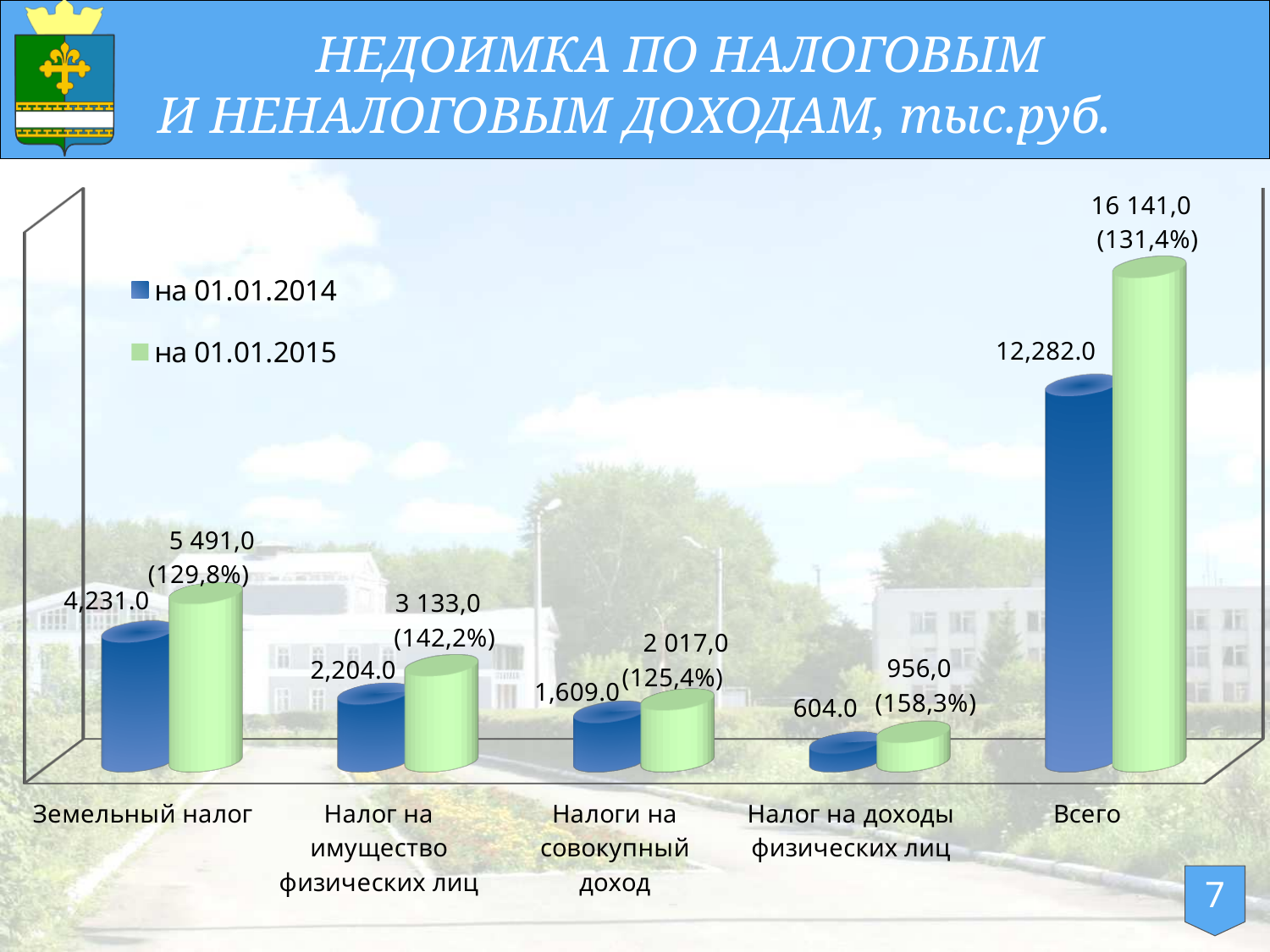
What is the value for Налоги на совокупный доход on 01.01.2014? 1,609.0 What is the value for Земельный налог on 01.01.2015? 5 491,0 What is the value for Налог на доходы физических лиц on 01.01.2015? 956,0 How many categories are shown on the x axis? 5 What is the value for Налог на имущество физических лиц on 01.01.2015? 3 133,0 What type of chart is shown on the slide? bar chart Excluding Всего, which category has the lowest value on 01.01.2014? Налог на доходы физических лиц What is the value for Всего on 01.01.2014? 12,282.0 Which is larger: the value for Налог на имущество физических лиц on 01.01.2015 or the value for Налоги на совокупный доход on 01.01.2015? Налог на имущество физических лиц on 01.01.2015 What percentage is shown next to the 01.01.2015 value for Налог на доходы физических лиц? 158,3% How many series does the legend list? 2 What is the value for Земельный налог on 01.01.2014? 4,231.0